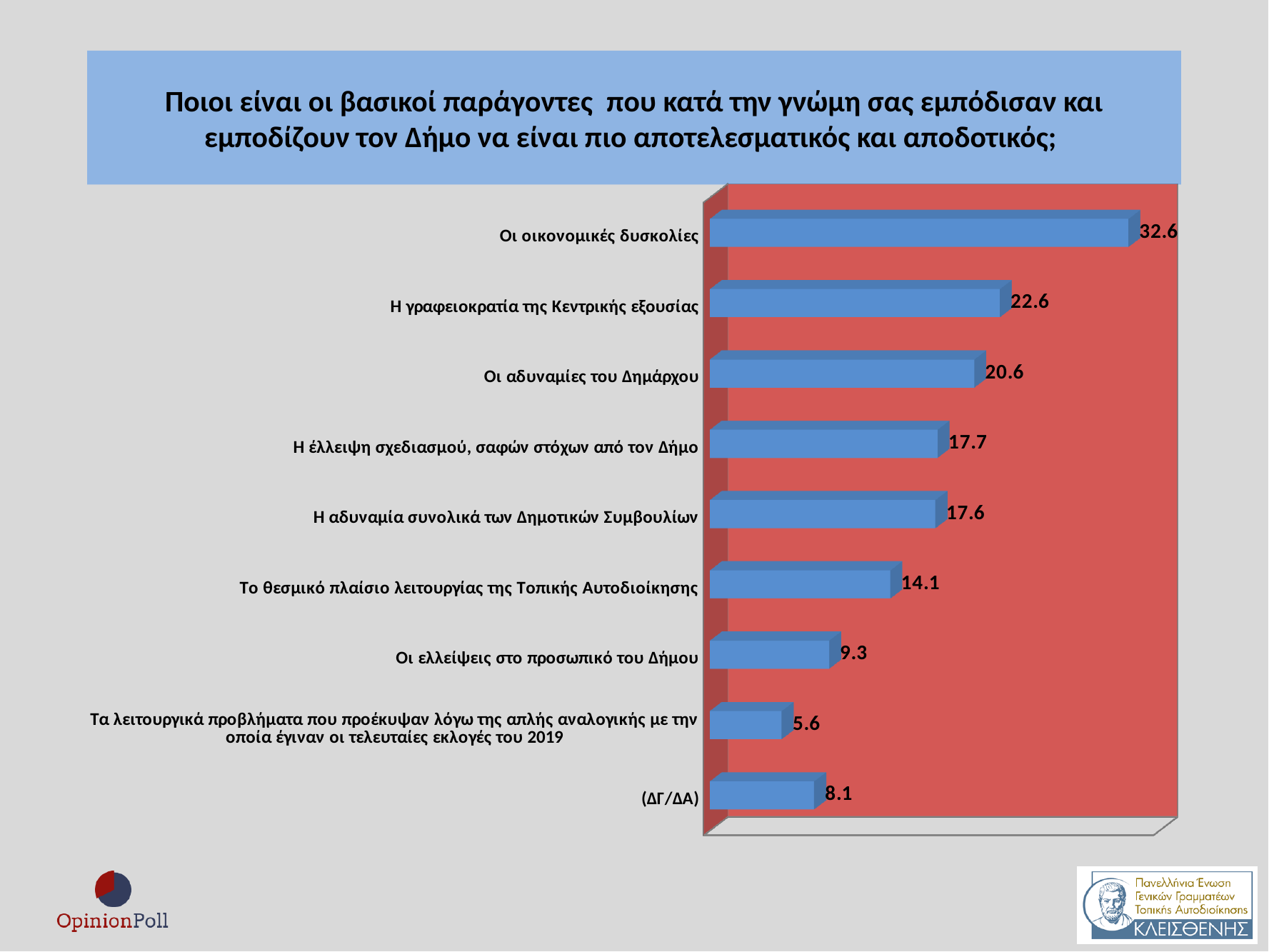
What kind of chart is shown on the slide? Bar chart Which is larger: the value for Οι αδυναμίες του Δημάρχου or the value for Η έλλειψη σχεδιασμού, σαφών στόχων από τον Δήμο? Οι αδυναμίες του Δημάρχου Which is larger: the value for (ΔΓ/ΔΑ) or the value for Οι ελλείψεις στο προσωπικό του Δήμου? Οι ελλείψεις στο προσωπικό του Δήμου What is the value for (ΔΓ/ΔΑ)? 8.1 How many categories are shown in the chart? 9 What is the difference between the values for Οι αδυναμίες του Δημάρχου and Το θεσμικό πλαίσιο λειτουργίας της Τοπικής Αυτοδιοίκησης? 6.5 What is the value for Η γραφειοκρατία της Κεντρικής εξουσίας? 22.6 What is the difference between the values for Οι οικονομικές δυσκολίες and Η γραφειοκρατία της Κεντρικής εξουσίας? 10.0 What is the value for Οι οικονομικές δυσκολίες? 32.6 What is the value for Οι ελλείψεις στο προσωπικό του Δήμου? 9.3 Which category has the lowest value? Τα λειτουργικά προβλήματα που προέκυψαν λόγω της απλής αναλογικής με την οποία έγιναν οι τελευταίες εκλογές του 2019 Which category has the highest value? Οι οικονομικές δυσκολίες